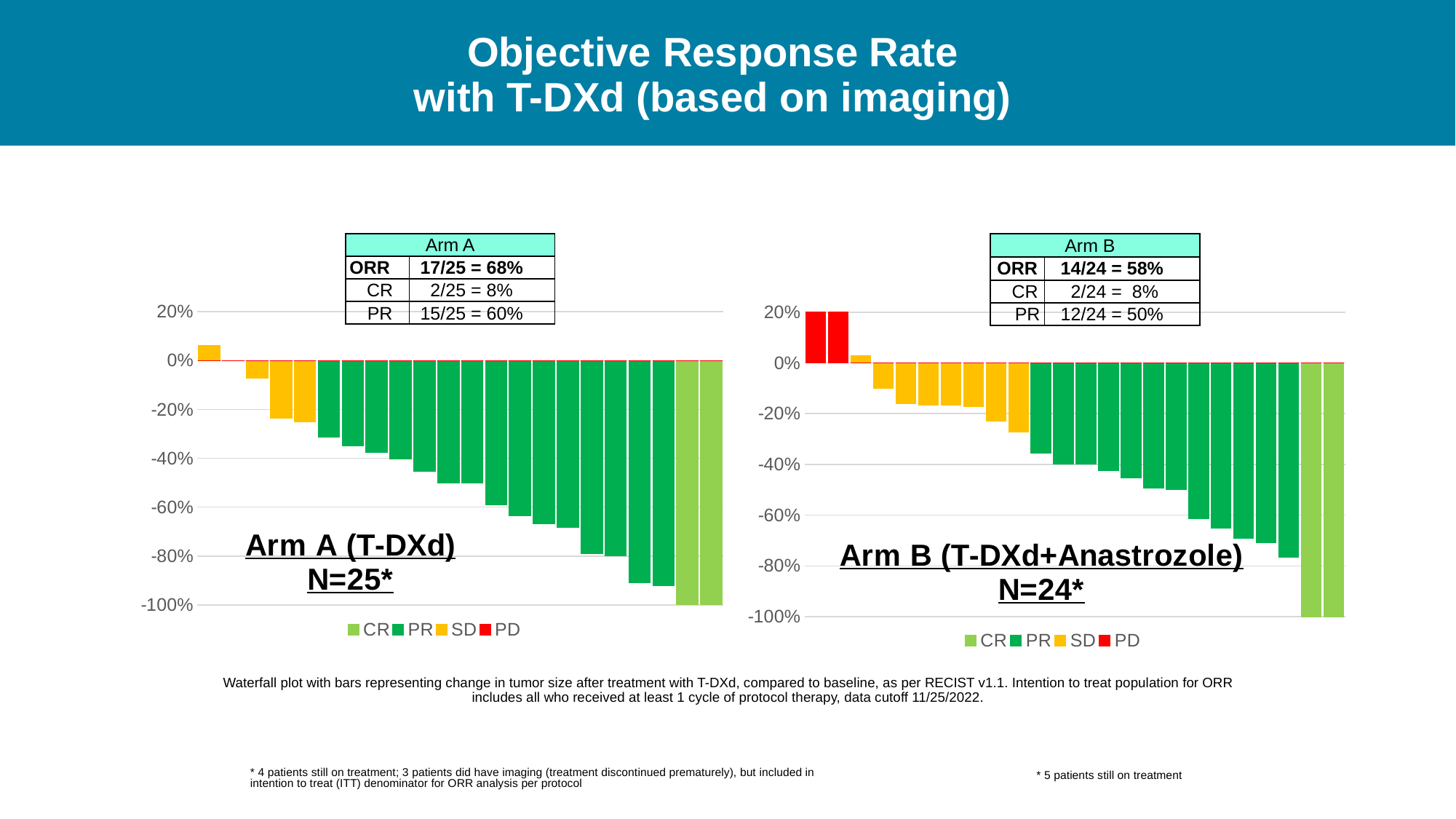
In the Arm A table, what is the PR value? 15/25 = 60% What kind of chart is used for Arm A (T-DXd)? bar chart In the Arm B table, what is the PR value? 12/24 = 50% What is the difference in ORR percentage between Arm A (68%) and Arm B (58%)? 10% On the Arm B (T-DXd+Anastrozole) chart, do the bar values rise or fall from left to right? fall On the Arm A (T-DXd) chart, what value do the light green CR bars reach? -100% Which arm has the higher ORR percentage, Arm A or Arm B? Arm A In the Arm A table, what is the ORR? 17/25 = 68% What are the legend entries on the Arm A (T-DXd) chart? CR, PR, SD, PD On the Arm B (T-DXd+Anastrozole) chart, how many red PD bars are there? 2 In the Arm B table, what is the ORR? 14/24 = 58% How many series does the legend list for the Arm B (T-DXd+Anastrozole) chart? 4